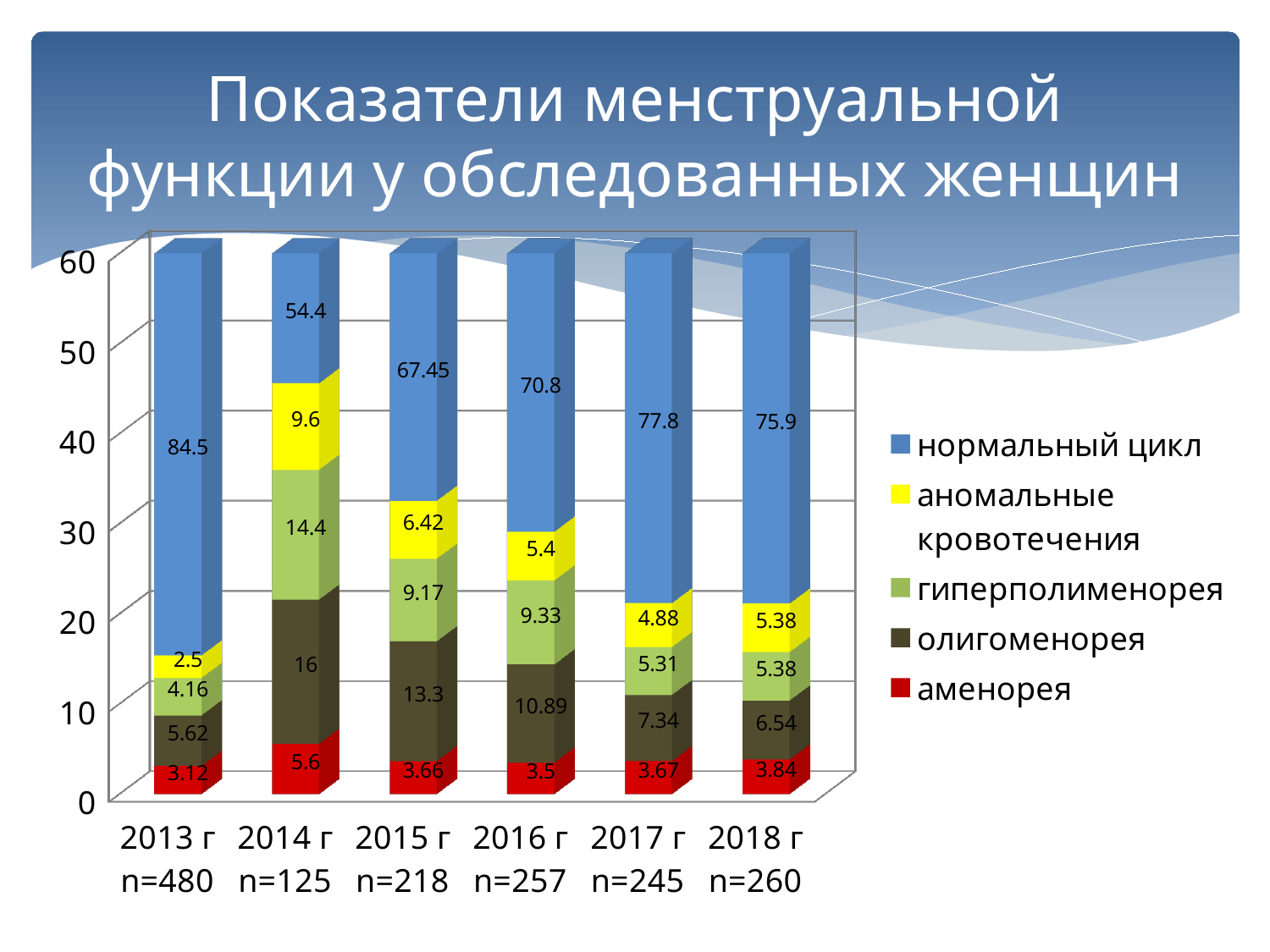
Which year has the larger value for олигоменорея, 2014 г or 2015 г? 2014 г How many series does the legend list? 5 What is the difference between the нормальный цикл values for 2017 г and 2018 г? 1.9 In which year is the value for аменорея the highest? 2014 г What is the value for олигоменорея in 2016 г? 10.89 What is the value for нормальный цикл in 2013 г? 84.5 In which year is the value for нормальный цикл the lowest? 2014 г What is the value for аменорея in 2014 г? 5.6 How many years (categories) are shown on the x axis? 6 In which year is the value for нормальный цикл the highest? 2013 г What is the value for гиперполименорея in 2017 г? 5.31 What kind of chart is shown on the slide? Stacked bar chart